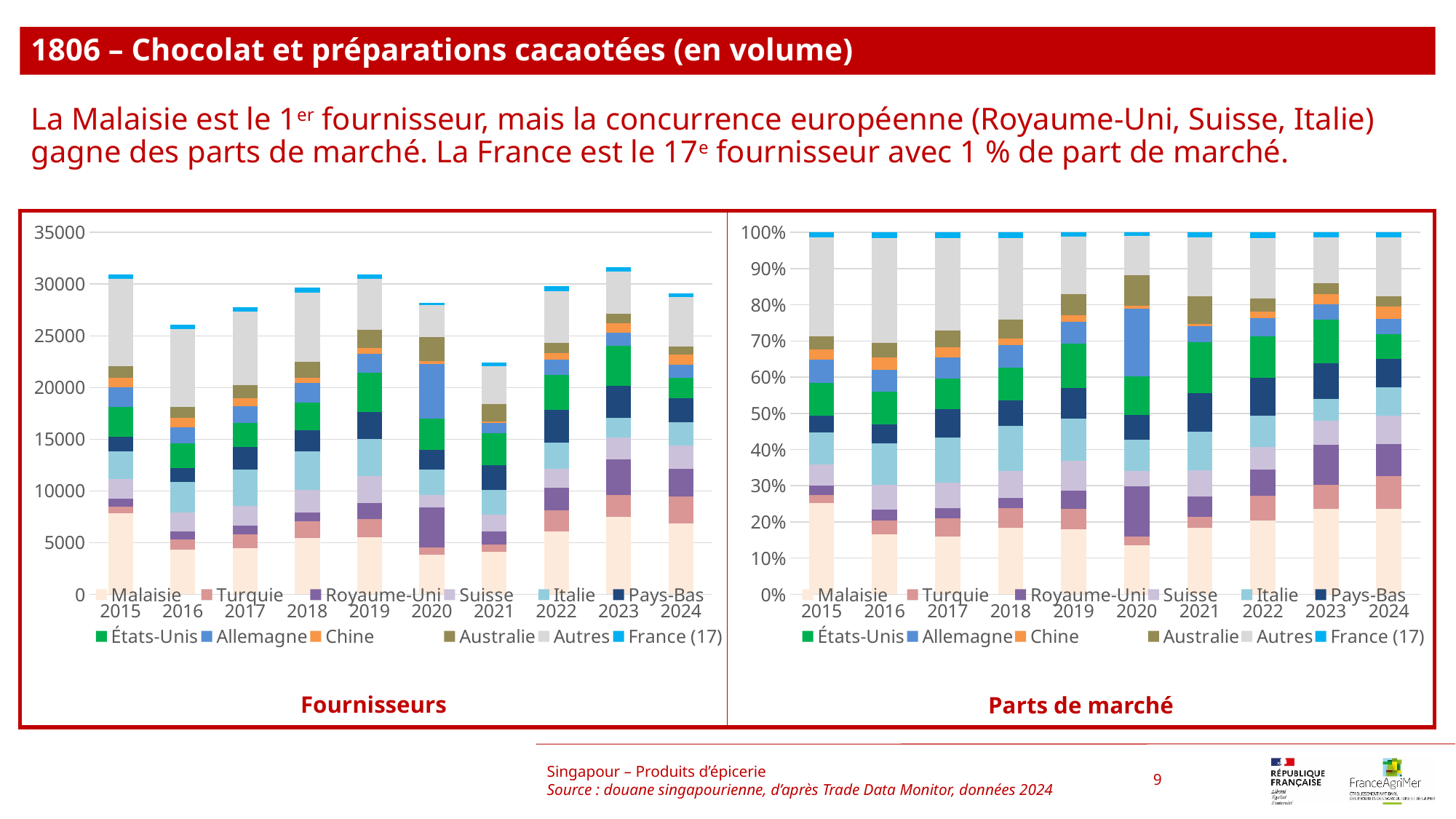
How many years are shown on the x axis of the "Fournisseurs" chart? 10 How many series does the legend of the "Parts de marché" chart list? 12 What kind of chart is the "Fournisseurs" chart on the left? stacked bar chart What is the title of the chart on the right side of the slide? Parts de marché In the "Fournisseurs" chart, which year has the lowest total bar? 2021 Which legend entry in the "Fournisseurs" chart is shown in light blue at the top of each bar? France (17) In the "Fournisseurs" chart, is the total bar for 2016 greater or less than 30000? less In the "Fournisseurs" chart, is the total bar for 2021 greater or less than 25000? less In the "Parts de marché" chart, is the Malaisie share in 2020 greater or less than 20%? less In the "Fournisseurs" chart, which total bar is larger, 2021 or 2022? 2022